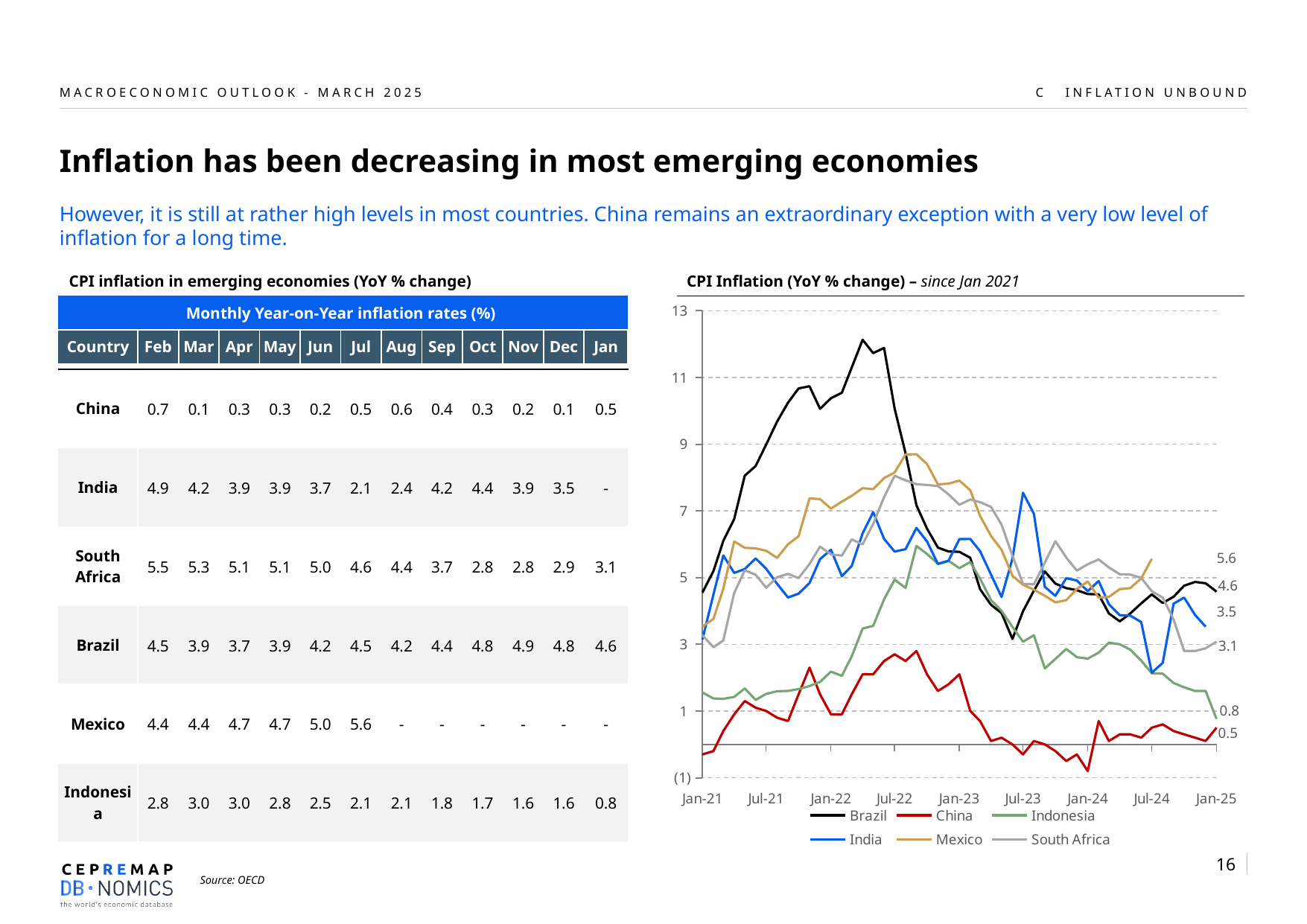
In the line chart, what is the final labelled value for Indonesia? 0.8 What is the title of the line chart? CPI Inflation (YoY % change) – since Jan 2021 In the line chart, what is the final labelled value for China? 0.5 In the line chart, which has the higher final labelled value, Brazil or India? Brazil How many series does the legend of the line chart list? 6 In the line chart, does the Indonesia line rise or fall between Jan-23 and Jan-25? fall In the line chart, is the highest value reached by the Brazil line greater or less than 11? greater In the line chart, which series reaches the highest peak over the period? Brazil In the line chart, what is the final labelled value for Brazil? 4.6 In the line chart, what is the final labelled value for South Africa? 3.1 In the line chart, what is the difference between the final labelled values for Brazil and China? 4.1 What kind of chart is shown on the right of the slide? line chart